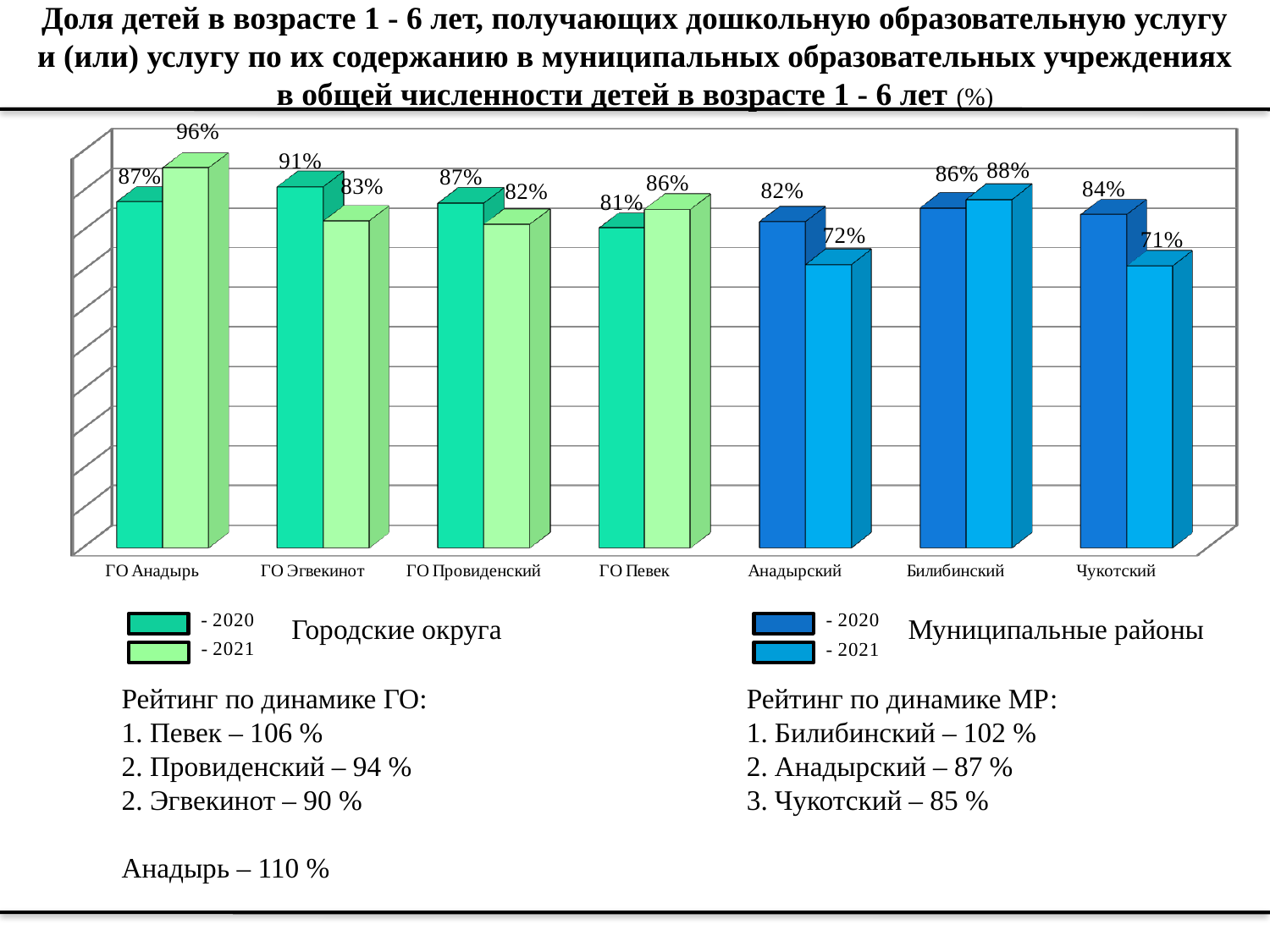
What kind of chart is shown on the slide? Bar chart Which is larger for Билибинский: the 2020 value or the 2021 value? 2021 What is the 2021 value for ГО Анадырь? 96% How many entries does the legend for Городские округа list? 2 How many categories are shown on the x axis? 7 What is the difference between the 2021 and 2020 values for ГО Анадырь? 9% What is the 2020 value for Чукотский? 84% Which category has the lowest 2021 value? Чукотский What is the difference between the 2020 and 2021 values for Анадырский? 10% Which category has the highest 2021 value? ГО Анадырь What is the 2020 value for ГО Эгвекинот? 91% What is the 2021 value for Анадырский? 72%